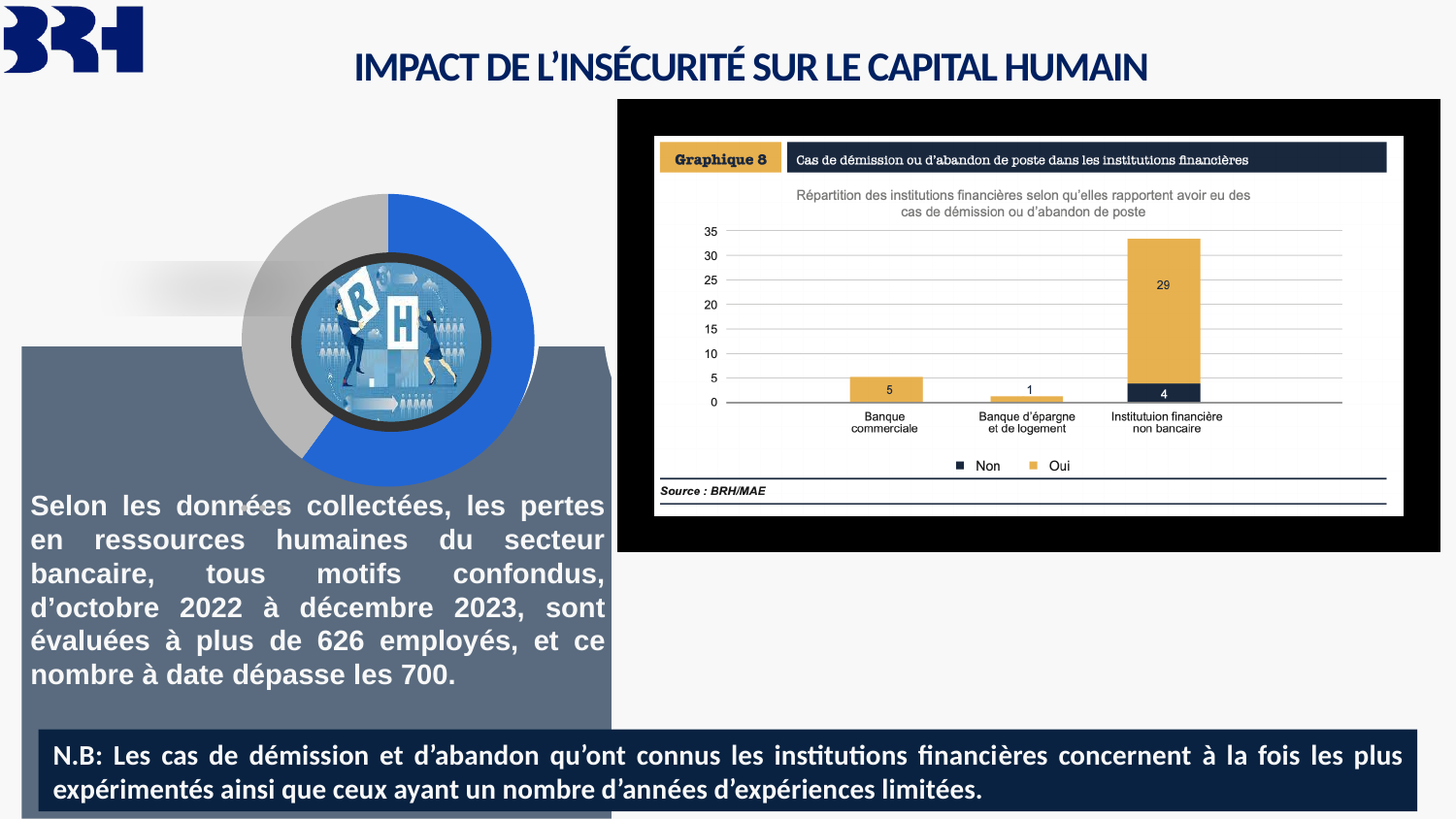
In Graphique 8, what is the difference between the 'Oui' value for Institutuion financière non bancaire and the 'Oui' value for Banque commerciale? 24 In Graphique 8, what is the value of the 'Non' series for Institutuion financière non bancaire? 4 In Graphique 8, which category has the highest 'Oui' value? Institutuion financière non bancaire In Graphique 8, what is the total of the stacked bar for Institutuion financière non bancaire? 33 In Graphique 8, what is the value of the 'Oui' series for Banque d'épargne et de logement? 1 In Graphique 8, what is the value of the 'Oui' series for Institutuion financière non bancaire? 29 In Graphique 8, what is the value of the 'Oui' series for Banque commerciale? 5 How many series does the legend of Graphique 8 list? 2 In Graphique 8, which category has the lowest 'Oui' value? Banque d'épargne et de logement How many categories are shown on the x axis of Graphique 8? 3 In Graphique 8, which has a larger 'Oui' value: Banque commerciale or Banque d'épargne et de logement? Banque commerciale What kind of chart is Graphique 8? Stacked bar chart